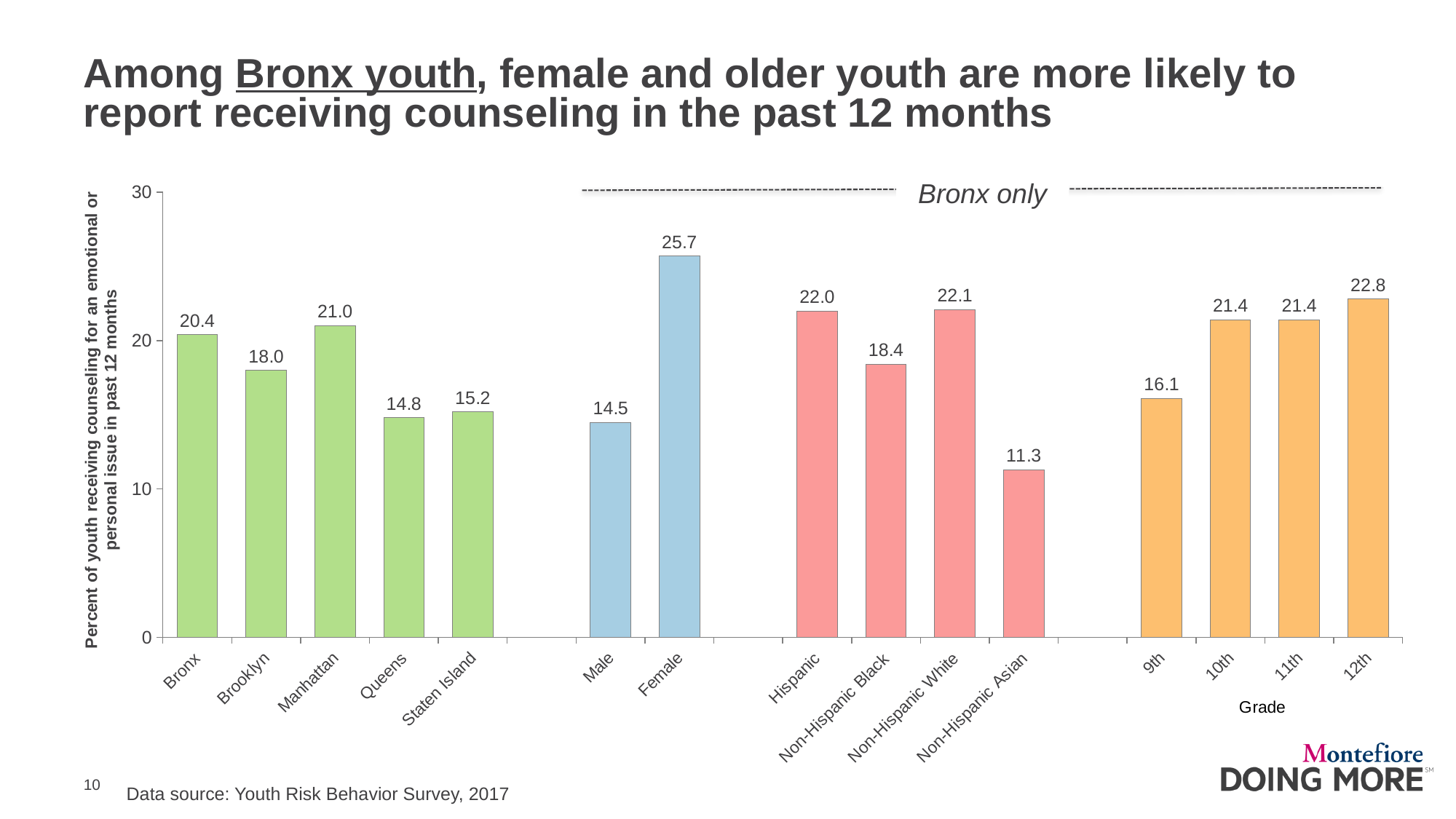
What is the difference between the values for 12th grade and 9th grade? 6.7 Which category has the highest value on the chart? Female What is the value for Queens? 14.8 Which category has the lowest value on the chart? Non-Hispanic Asian Do the values rise or fall from 9th grade to 12th grade? rise What is the value for Female? 25.7 What is the value for Non-Hispanic Asian? 11.3 Is the value for Staten Island greater or less than 20? less Which is larger, the value for Manhattan or the value for Brooklyn? Manhattan What is the difference between the values for Female and Male? 11.2 What kind of chart is shown on the slide? bar chart How many bars are plotted on the chart? 15